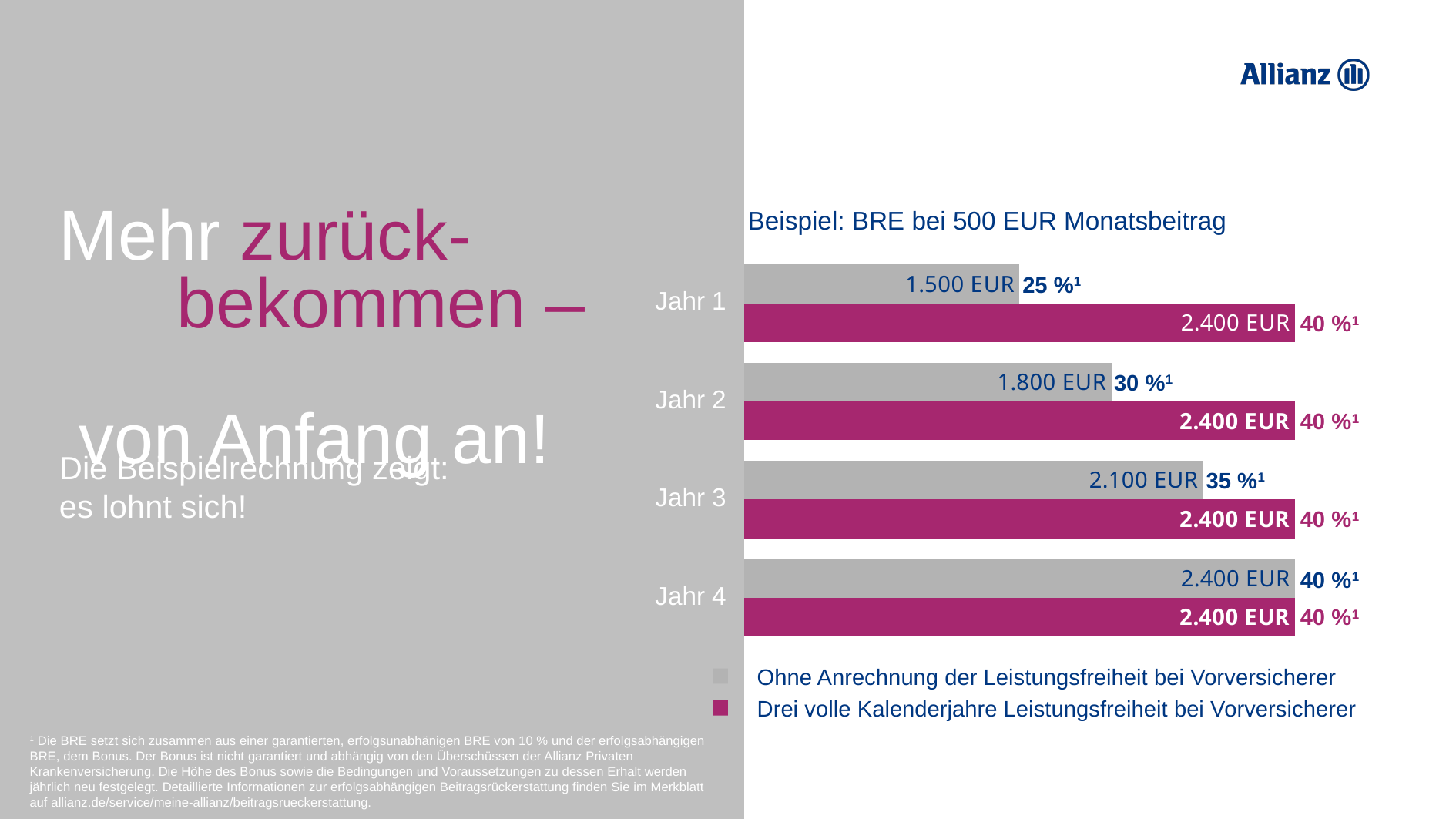
What is the title of the chart? Beispiel: BRE bei 500 EUR Monatsbeitrag Which series has the larger value for Jahr 3? Drei volle Kalenderjahre Leistungsfreiheit bei Vorversicherer How many categories (years) are shown on the chart? 4 What percentage is shown for Jahr 2 in the series 'Ohne Anrechnung der Leistungsfreiheit bei Vorversicherer'? 30 % What is the value for Jahr 1 in the series 'Ohne Anrechnung der Leistungsfreiheit bei Vorversicherer'? 1.500 EUR What is the value for Jahr 3 in the series 'Ohne Anrechnung der Leistungsfreiheit bei Vorversicherer'? 2.100 EUR Do the values in the series 'Ohne Anrechnung der Leistungsfreiheit bei Vorversicherer' rise or fall from Jahr 1 to Jahr 4? Rise How many series does the legend list? 2 What kind of chart is shown on the slide? Bar chart What is the value for Jahr 2 in the series 'Drei volle Kalenderjahre Leistungsfreiheit bei Vorversicherer'? 2.400 EUR Which year has the lowest value in the series 'Ohne Anrechnung der Leistungsfreiheit bei Vorversicherer'? Jahr 1 What is the difference between the two series' values for Jahr 1? 900 EUR